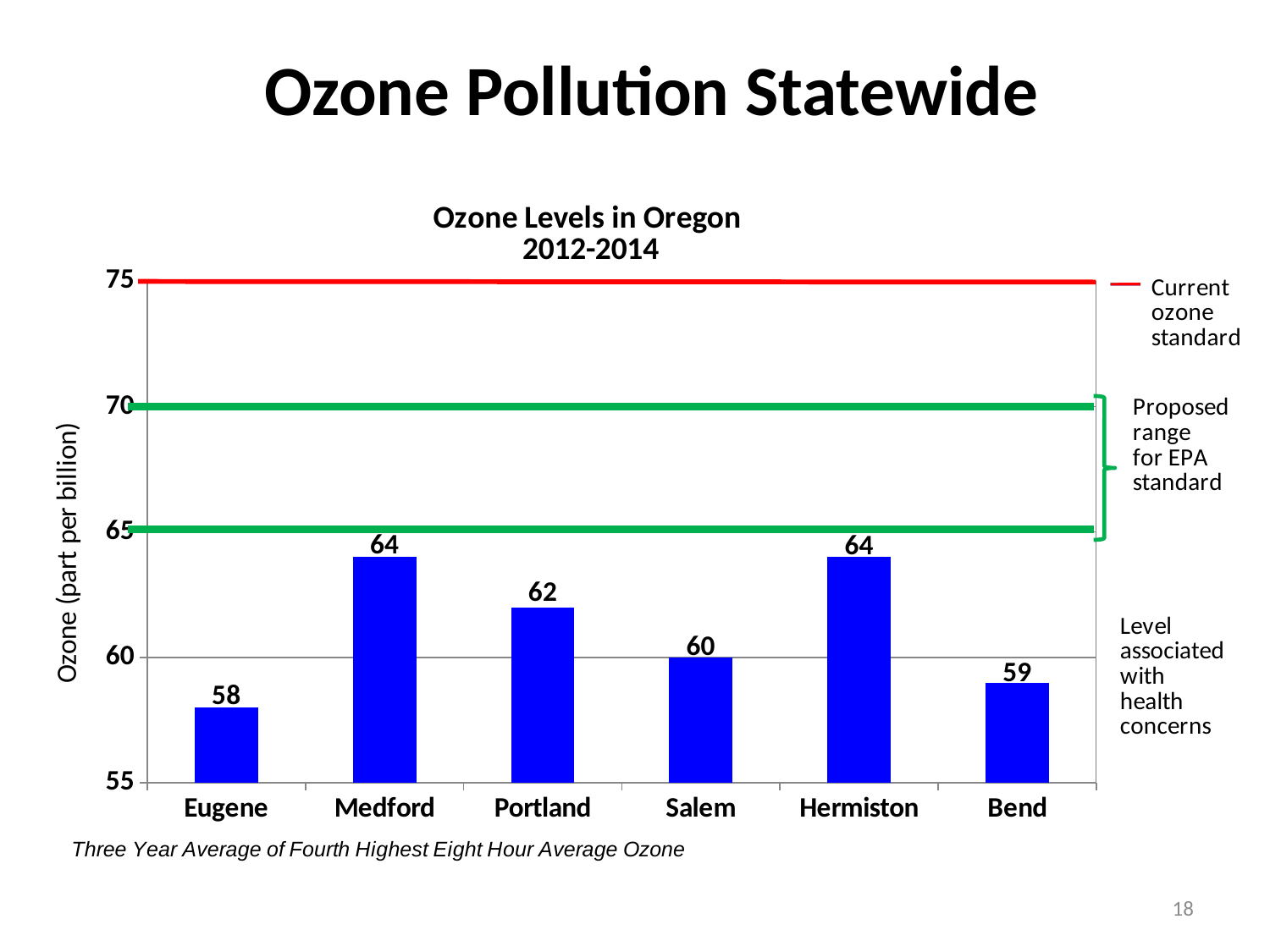
What does the red line on the chart represent? Current ozone standard What is the ozone level for Bend? 59 What is the difference between the ozone levels of Hermiston and Eugene? 6 Which city has the lowest ozone level? Eugene Which has a higher ozone level, Portland or Bend? Portland What is the title of the chart? Ozone Levels in Oregon 2012-2014 How many cities are shown on the chart? 6 What is the ozone level for Portland? 62 What kind of chart is shown on the slide? bar chart What is the ozone level for Eugene? 58 What is the difference between the ozone levels of Medford and Salem? 4 Is the value for Hermiston greater or less than 65? less